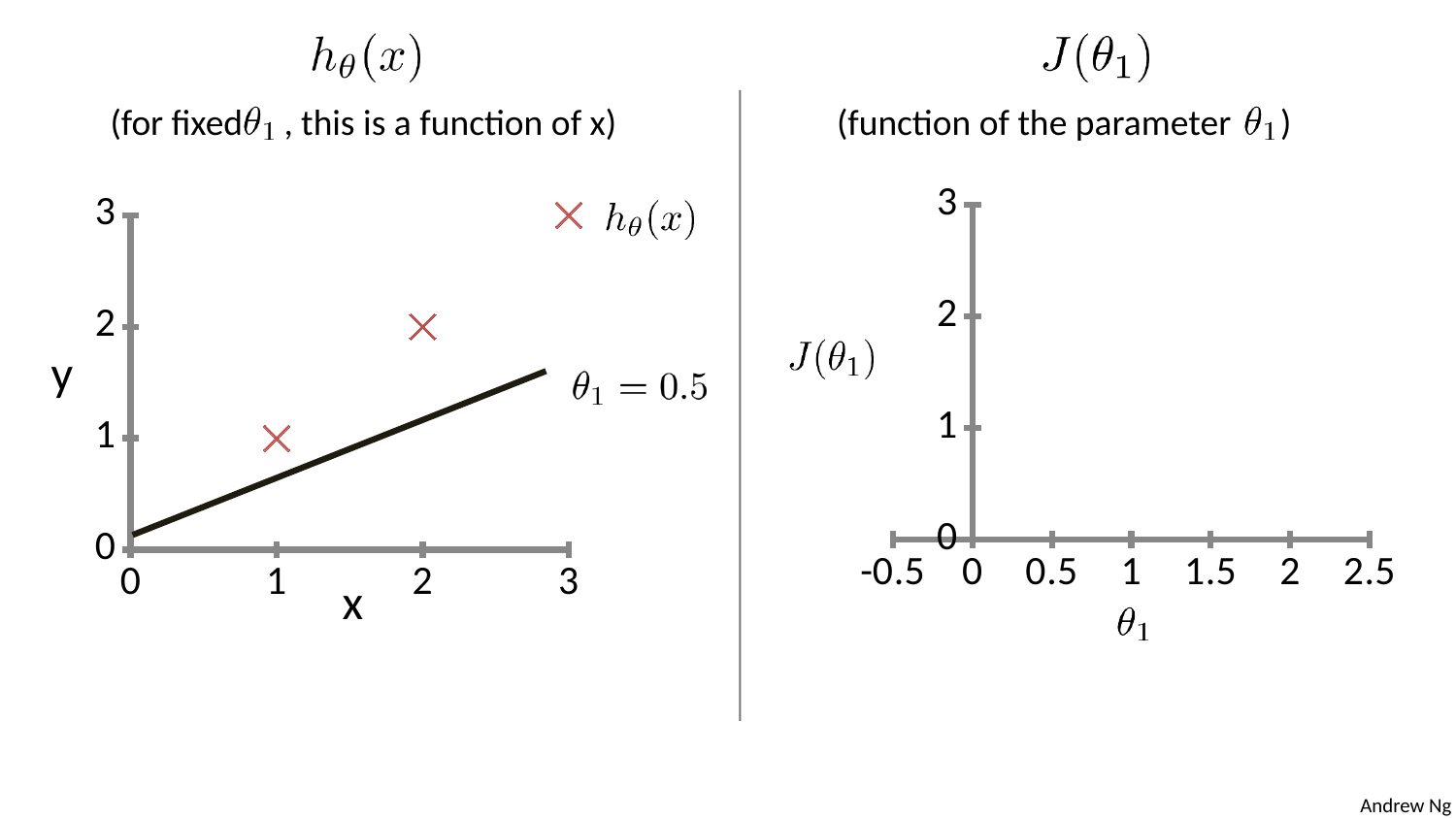
On the left chart h_θ(x), which data point has the larger y value, the one at x = 2 or the one at x = 1? x = 2 On the left chart h_θ(x), do the y values of the data points rise or fall as x increases? rise On the left chart h_θ(x), is the value of the θ₁ = 0.5 line at x = 2 greater or less than 2? less On the left chart h_θ(x), what value of θ₁ is labelled on the straight line? θ₁ = 0.5 On the left chart h_θ(x), how many red X data points are plotted? 3 On the left chart h_θ(x), what is the y value of the data point at x = 3? 3 On the left chart h_θ(x), at which x value is the data point with the lowest y value? 1 On the left chart h_θ(x), what is the y value of the data point at x = 2? 2 On the left chart h_θ(x), what is the difference between the y values of the data points at x = 3 and x = 1? 2 On the left chart h_θ(x), at which x value is the data point with the highest y value? 3 On the right chart J(θ₁), what is the highest value shown on the vertical axis? 3 On the left chart h_θ(x), what is the y value of the data point at x = 1? 1